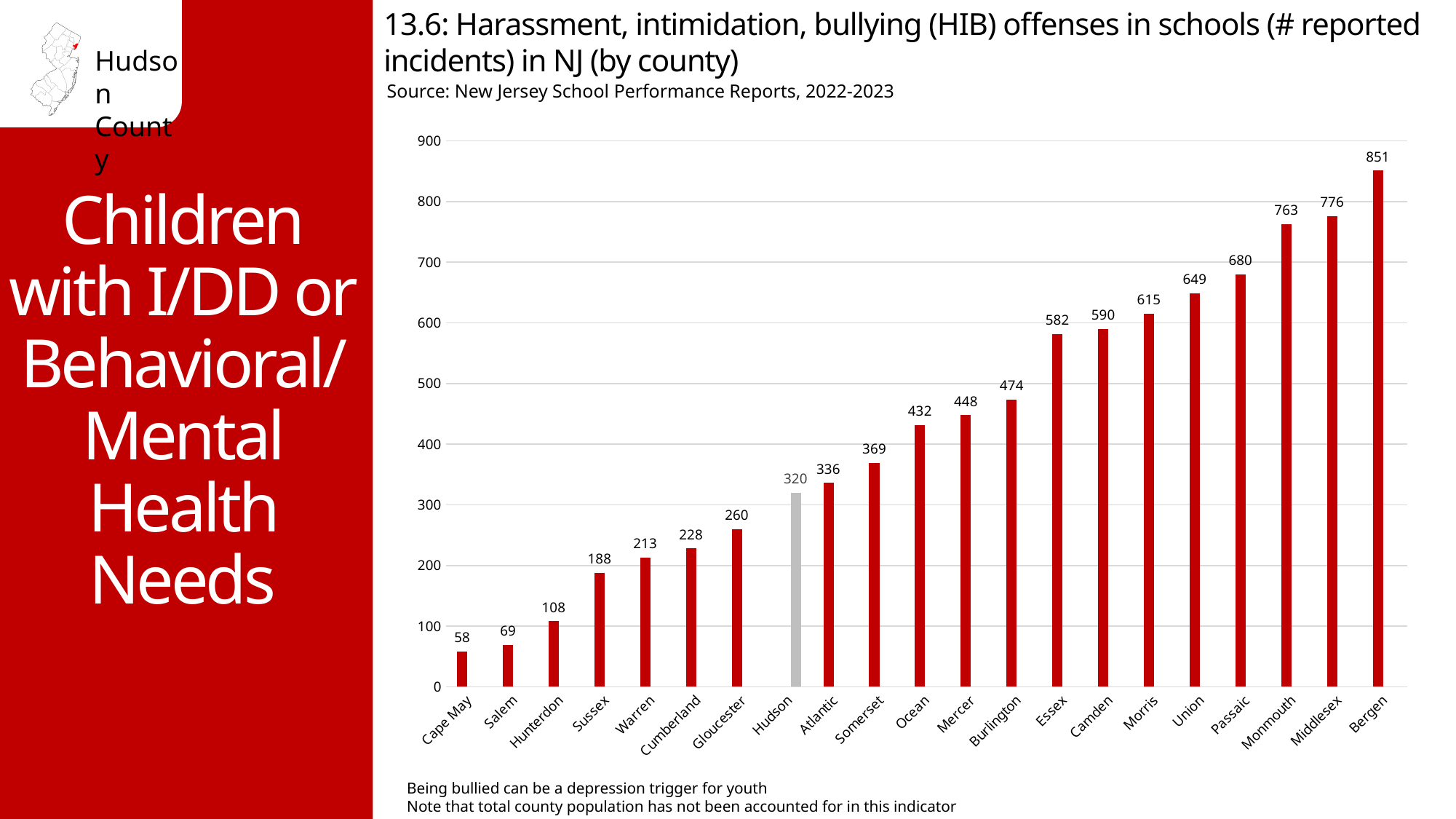
Which county has more reported HIB incidents, Essex or Ocean? Essex How many counties are shown on the chart? 21 What is the difference in reported HIB incidents between Bergen and Hudson? 531 Is the value for Passaic greater or less than 600? greater What is the number of reported HIB incidents for Hudson? 320 What kind of chart is shown on the slide? Bar chart Which county has the highest number of reported HIB incidents? Bergen Do the values rise or fall moving from left to right along the x axis? Rise What is the number of reported HIB incidents for Bergen? 851 What is the difference in reported HIB incidents between Middlesex and Monmouth? 13 What is the number of reported HIB incidents for Cumberland? 228 Which county has the lowest number of reported HIB incidents? Cape May